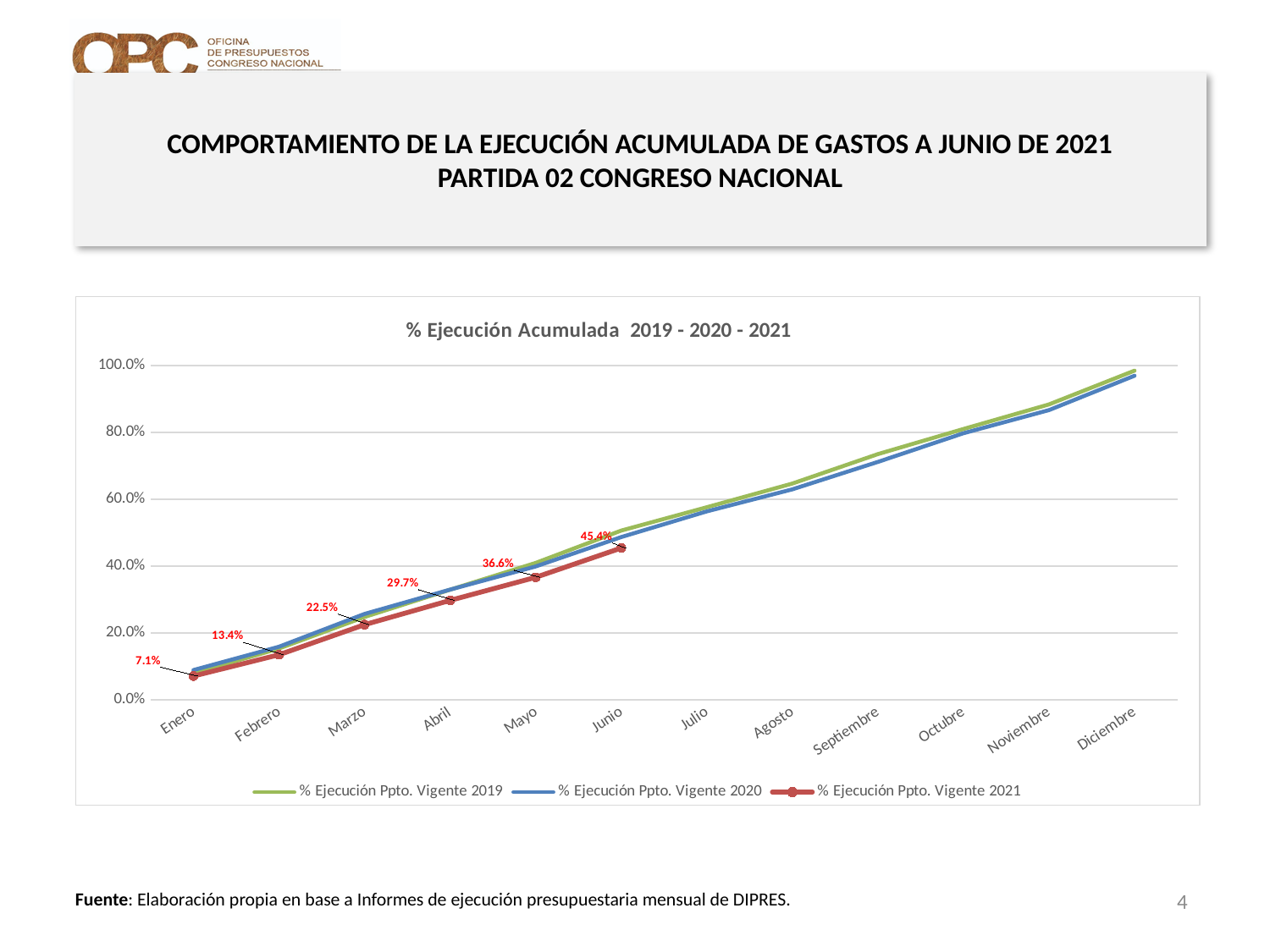
By how many percentage points does the 2021 series increase from Mayo to Junio? 8.8 How many series does the legend list? 3 By how many percentage points does the 2021 series increase from Enero to Febrero? 6.3 How many months are shown on the x axis? 12 Is the value for % Ejecución Ppto. Vigente 2019 in Agosto greater or less than 80%? less What kind of chart is shown on the slide? Line chart Do the values of the 2020 series rise or fall from Enero to Diciembre? Rise What is the value of % Ejecución Ppto. Vigente 2021 for Marzo? 22.5% What is the value of % Ejecución Ppto. Vigente 2021 for Abril? 29.7% What is the value of % Ejecución Ppto. Vigente 2021 for Enero? 7.1% What is the value of % Ejecución Ppto. Vigente 2021 for Junio? 45.4% Which month has the highest labelled value for the 2021 series? Junio